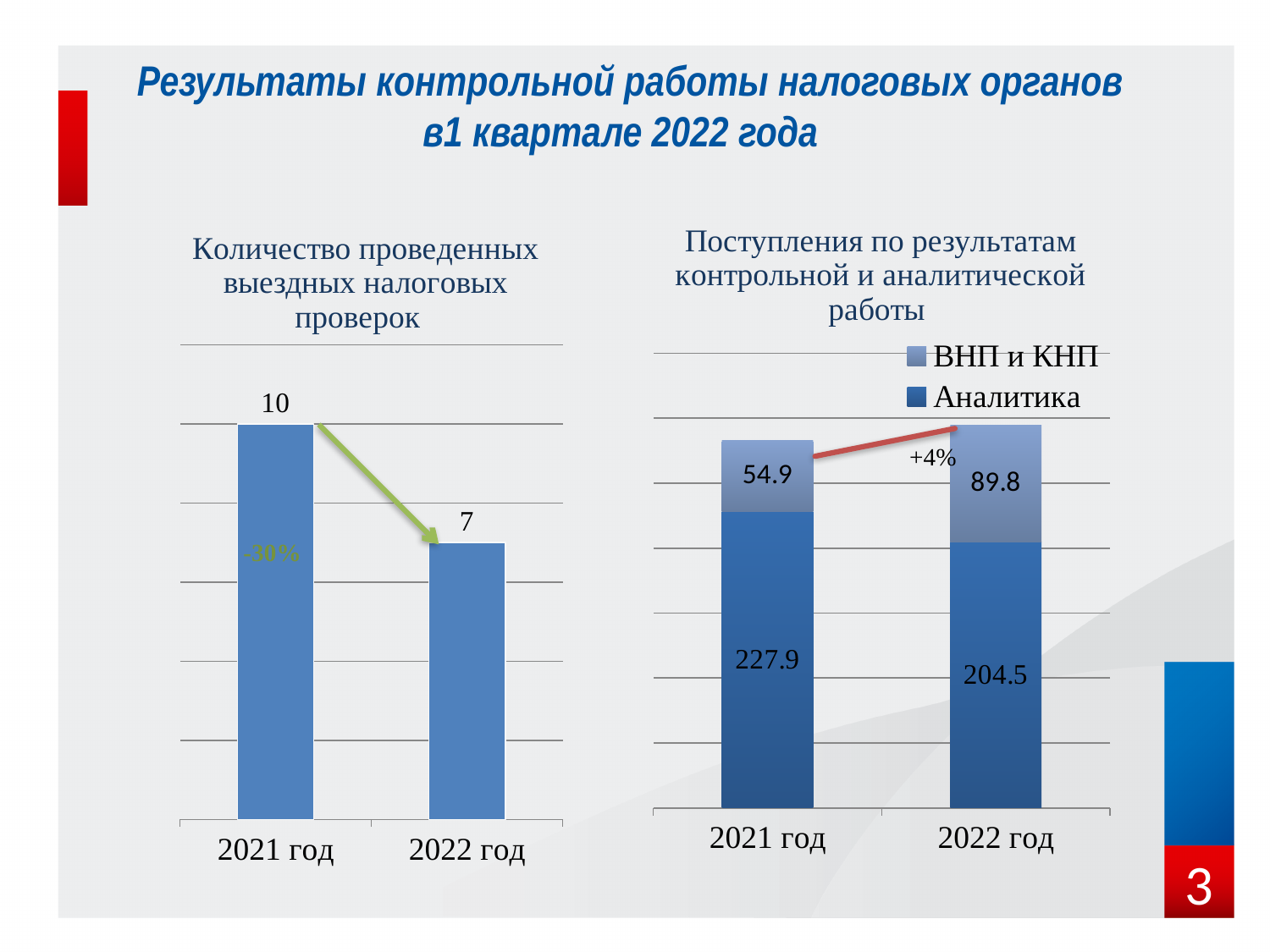
In the chart 'Количество проведенных выездных налоговых проверок', what is the difference between the 2021 год and 2022 год values? 3 In the chart 'Количество проведенных выездных налоговых проверок', what is the value for 2021 год? 10 In the chart 'Поступления по результатам контрольной и аналитической работы', which year has the larger ВНП и КНП value, 2021 год or 2022 год? 2022 год In the chart 'Количество проведенных выездных налоговых проверок', do the values rise or fall from 2021 год to 2022 год? fall In the chart 'Поступления по результатам контрольной и аналитической работы', what is the value of Аналитика for 2021 год? 227.9 In the chart 'Поступления по результатам контрольной и аналитической работы', what is the difference between the Аналитика values for 2021 год and 2022 год? 23.4 In the chart 'Поступления по результатам контрольной и аналитической работы', what is the value of ВНП и КНП for 2022 год? 89.8 In the chart 'Поступления по результатам контрольной и аналитической работы', what is the total of the stacked bar for 2022 год? 294.3 What kind of chart is 'Количество проведенных выездных налоговых проверок'? bar chart In the chart 'Поступления по результатам контрольной и аналитической работы', what is the total of the stacked bar for 2021 год? 282.8 How many series does the legend of the chart 'Поступления по результатам контрольной и аналитической работы' list? 2 In the chart 'Количество проведенных выездных налоговых проверок', what is the value for 2022 год? 7